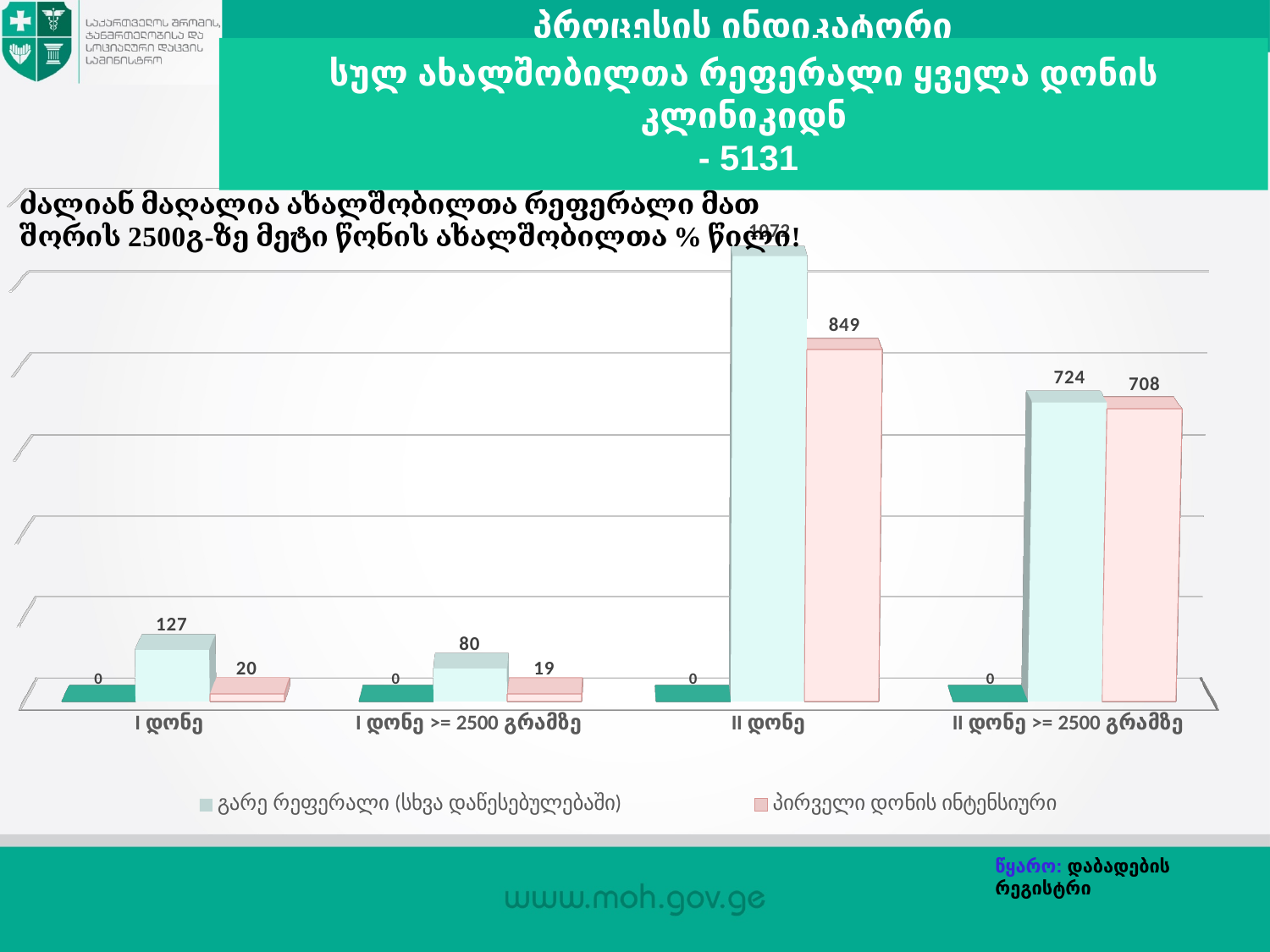
In which category is პირველი დონის ინტენსიური highest? II დონე What is the difference between გარე რეფერალი and პირველი დონის ინტენსიური for II დონე >= 2500 გრამზე? 16 What is the value of გარე რეფერალი (სხვა დაწესებულებაში) for I დონე? 127 What is the value of გარე რეფერალი (სხვა დაწესებულებაში) for II დონე >= 2500 გრამზე? 724 How many categories are shown on the x axis? 4 What is the difference between გარე რეფერალი and პირველი დონის ინტენსიური for I დონე? 107 What is the value of პირველი დონის ინტენსიური for I დონე? 20 What is the value of პირველი დონის ინტენსიური for II დონე >= 2500 გრამზე? 708 For I დონე >= 2500 გრამზე, which is larger: გარე რეფერალი or პირველი დონის ინტენსიური? გარე რეფერალი What is the value of გარე რეფერალი (სხვა დაწესებულებაში) for I დონე >= 2500 გრამზე? 80 How many series does the legend list? 2 What is the value of პირველი დონის ინტენსიური for II დონე? 849